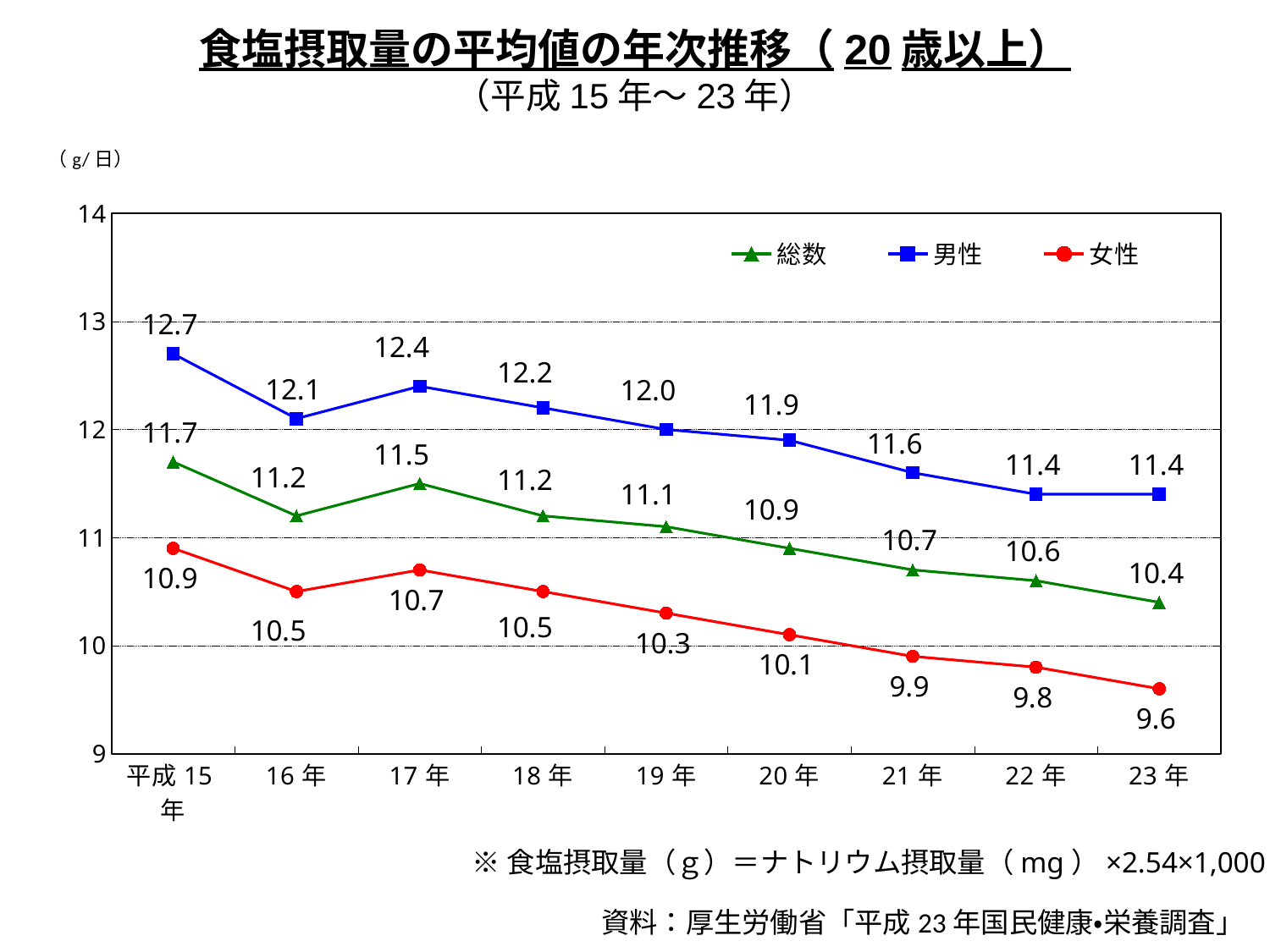
What is the value for 総数 in 19年? 11.1 What is the value for 女性 in 23年? 9.6 How many series does the legend list? 3 What is the value for 男性 in 平成15年? 12.7 In which year is the 女性 value lowest? 23年 Which is larger in 17年, the 総数 value or the 女性 value? 総数 Do the 総数 values generally rise or fall from 平成15年 to 23年? fall How many years are shown on the x axis? 9 In which year is the 男性 value highest? 平成15年 What kind of chart is this? line chart Is the value for 女性 in 21年 greater or less than 10? less What is the difference between the 男性 and 女性 values in 平成15年? 1.8